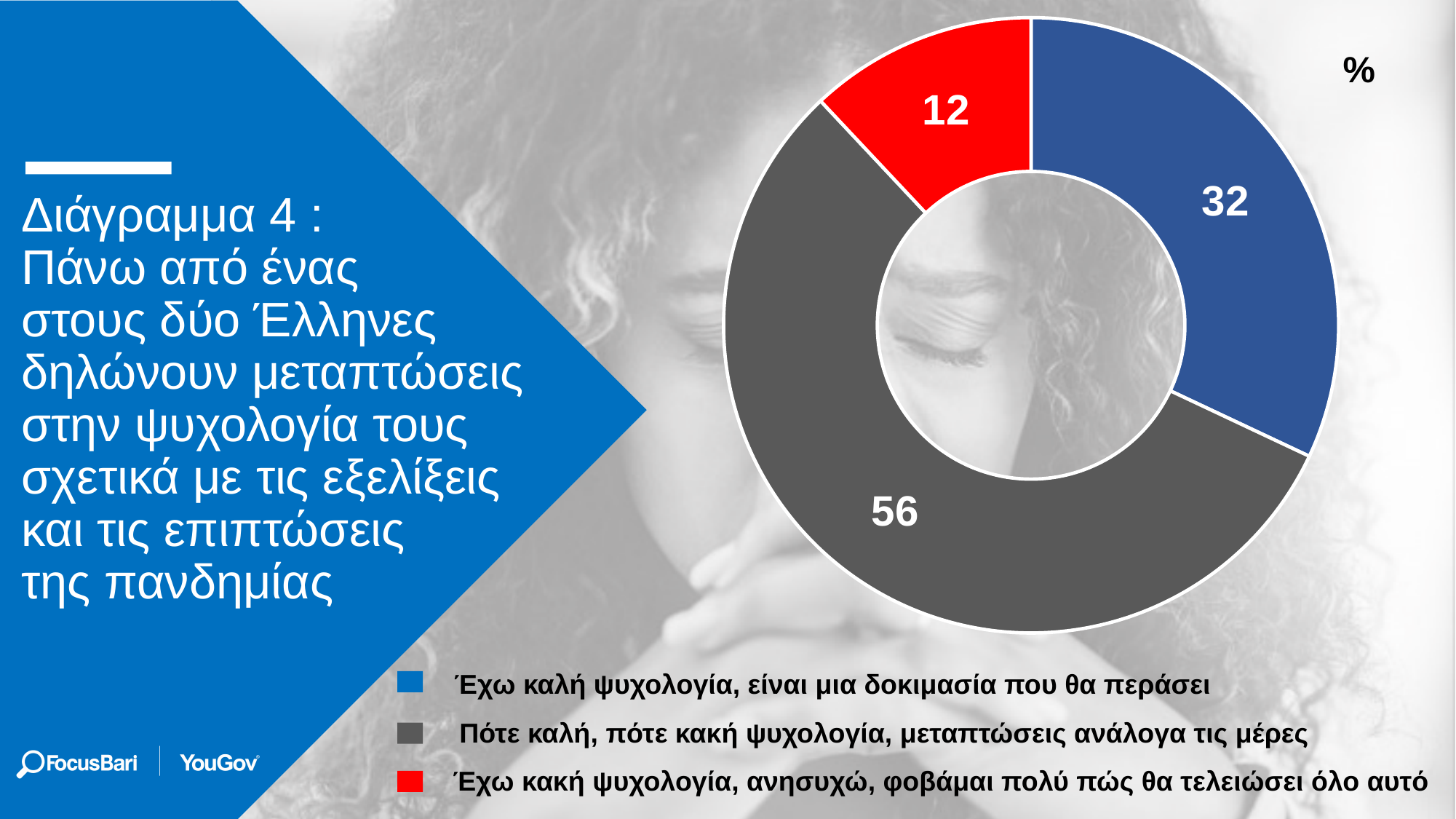
What is the difference between the value for 'Έχω καλή ψυχολογία' and the value for 'Έχω κακή ψυχολογία'? 20 How many slices does the chart have? 3 What type of chart is shown on the slide? Donut (pie) chart What value is shown for the slice 'Έχω κακή ψυχολογία, ανησυχώ, φοβάμαι πολύ πώς θα τελειώσει όλο αυτό'? 12 What value is shown for the slice 'Πότε καλή, πότε κακή ψυχολογία, μεταπτώσεις ανάλογα τις μέρες'? 56 Which category has the largest share of the chart? Πότε καλή, πότε κακή ψυχολογία, μεταπτώσεις ανάλογα τις μέρες Which category has the smallest share of the chart? Έχω κακή ψυχολογία, ανησυχώ, φοβάμαι πολύ πώς θα τελειώσει όλο αυτό Which is larger: the blue slice or the red slice? The blue slice What unit symbol is shown next to the chart? % What is the difference between the largest slice (56) and the smallest slice (12)? 44 What colour is the slice labelled 56? Grey What value is shown for the slice 'Έχω καλή ψυχολογία, είναι μια δοκιμασία που θα περάσει'? 32